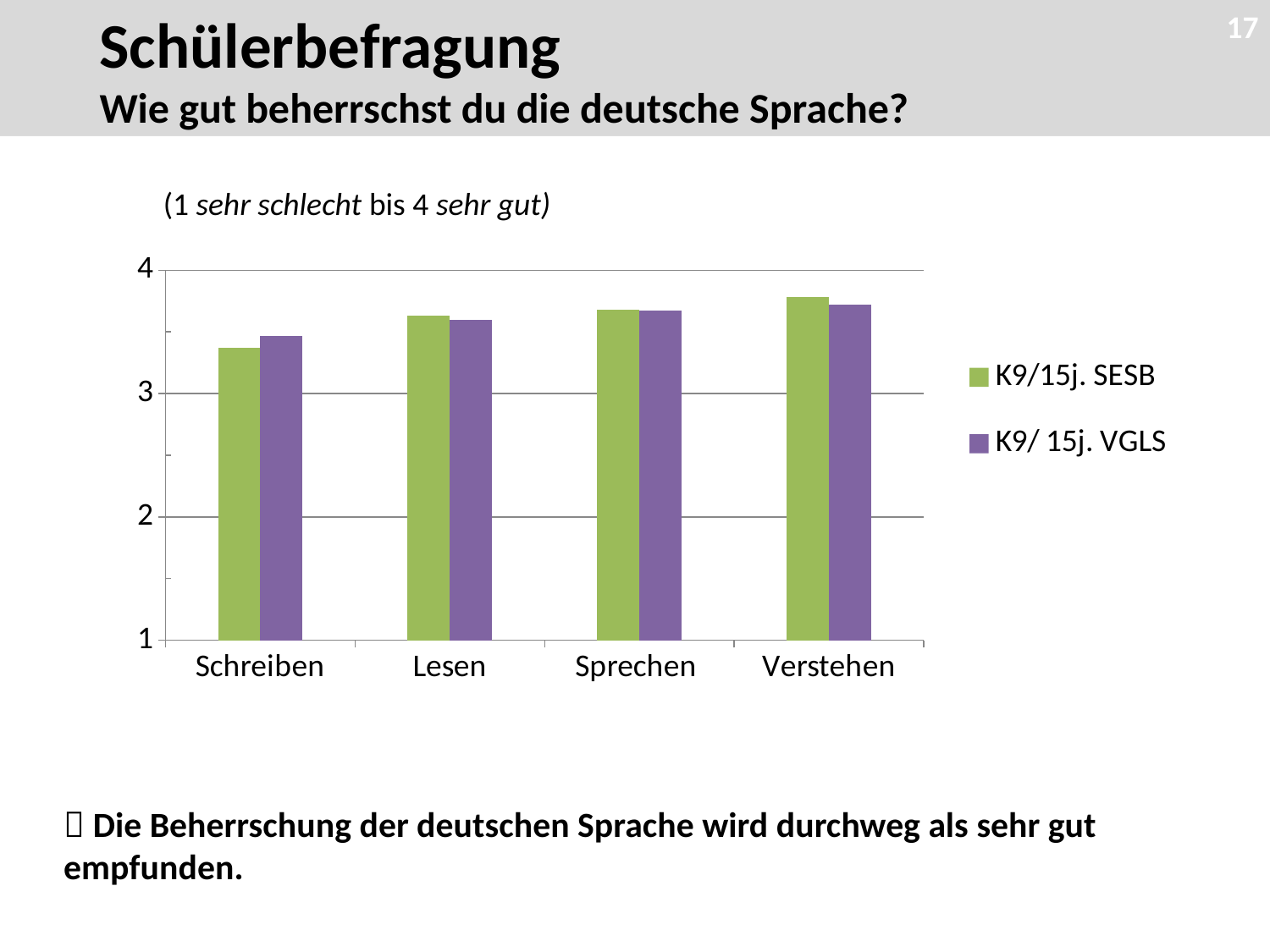
Which category has the highest value for the K9/15j. SESB series? Verstehen What kind of chart is shown on the slide? bar chart For Schreiben, which series has the larger value, K9/15j. SESB or K9/ 15j. VGLS? K9/ 15j. VGLS Which category has the lowest value for the K9/15j. SESB series? Schreiben For Verstehen, which series has the larger value, K9/15j. SESB or K9/ 15j. VGLS? K9/15j. SESB Do the values for the K9/15j. SESB series rise or fall from Schreiben to Verstehen? rise Which colour represents the K9/ 15j. VGLS series in the chart? purple Is the value for Schreiben in the K9/15j. SESB series greater or less than 3? greater Is the value for Verstehen in the K9/ 15j. VGLS series greater or less than 4? less How many categories are shown on the x axis of the chart? 4 How many series does the chart's legend list? 2 Which category has the lowest value for the K9/ 15j. VGLS series? Schreiben